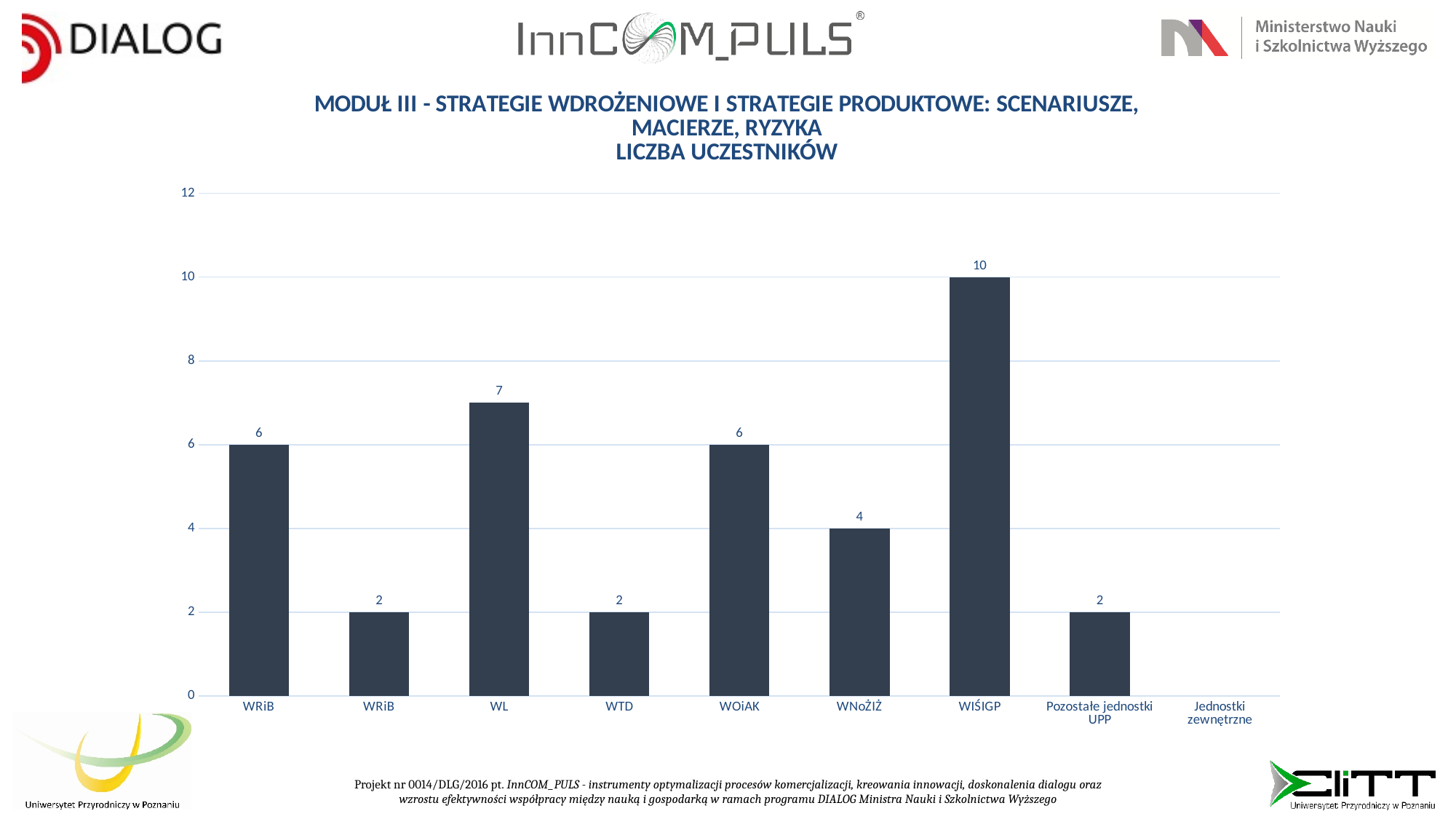
Which is larger, the value for WL or the value for WOiAK? WL Which category has the highest value? WIŚIGP What is the difference between the values for WIŚIGP and WL? 3 What is the difference between the values for WOiAK and WTD? 4 What is the last line of the chart title? LICZBA UCZESTNIKÓW How many category labels are shown on the x axis? 9 What is the value for Pozostałe jednostki UPP? 2 What is the value for WL? 7 What is the value for WNoŻIŻ? 4 What kind of chart is shown on the slide? bar chart What is the value for WIŚIGP? 10 Is the value for WIŚIGP greater or less than 8? greater